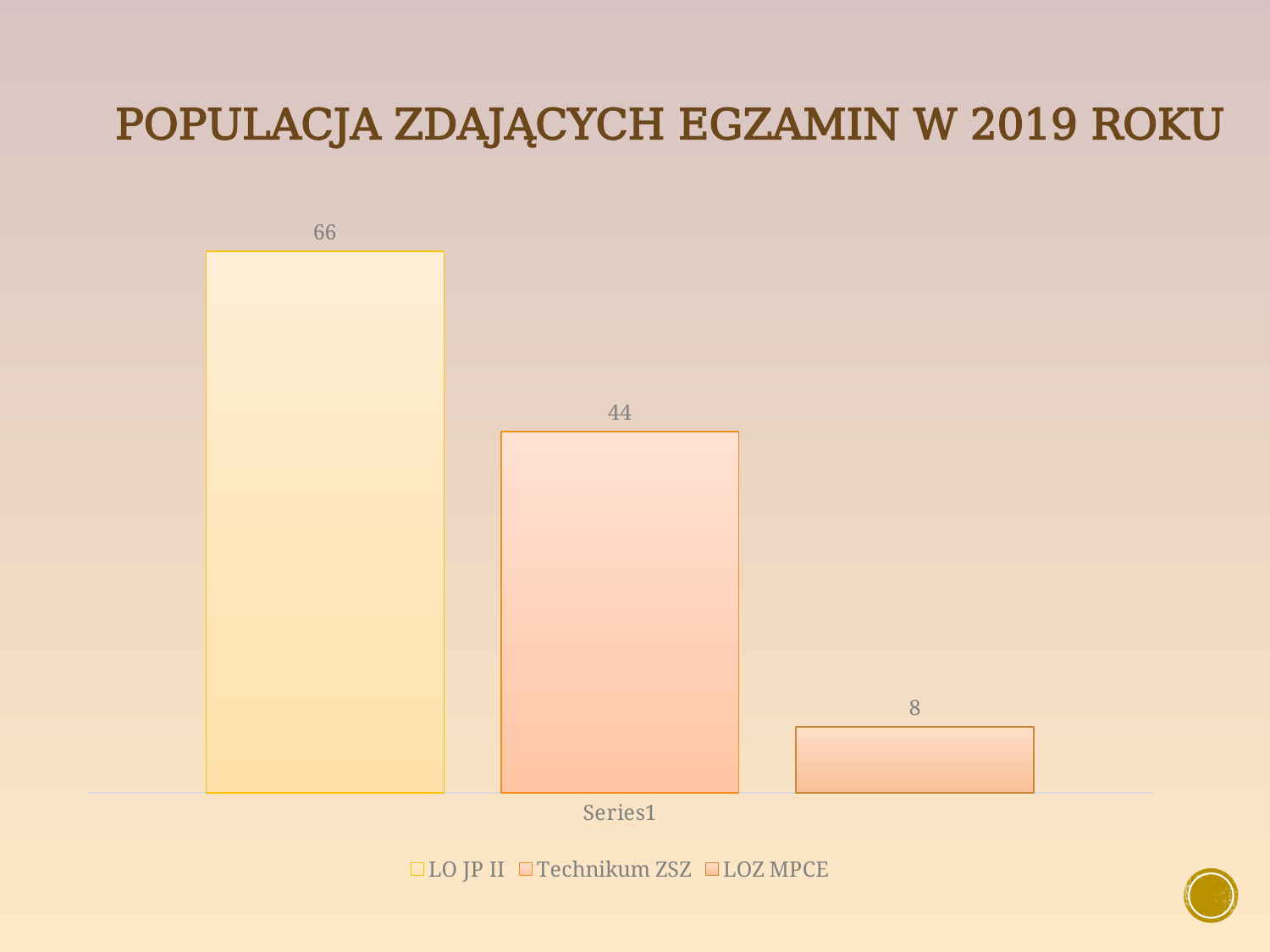
What is the value for LOZ MPCE? 8 Which legend entry has the lowest value? LOZ MPCE Which is larger, the value for Technikum ZSZ or the value for LOZ MPCE? Technikum ZSZ What is the value for LO JP II? 66 How many bars are plotted in the chart? 3 What is the value for Technikum ZSZ? 44 What is the title of the slide? POPULACJA ZDAJĄCYCH EGZAMIN W 2019 ROKU What kind of chart is shown on the slide? bar chart What is the difference between the values for Technikum ZSZ and LOZ MPCE? 36 Which legend entry has the highest value? LO JP II How many entries does the legend list? 3 What is the difference between the values for LO JP II and Technikum ZSZ? 22